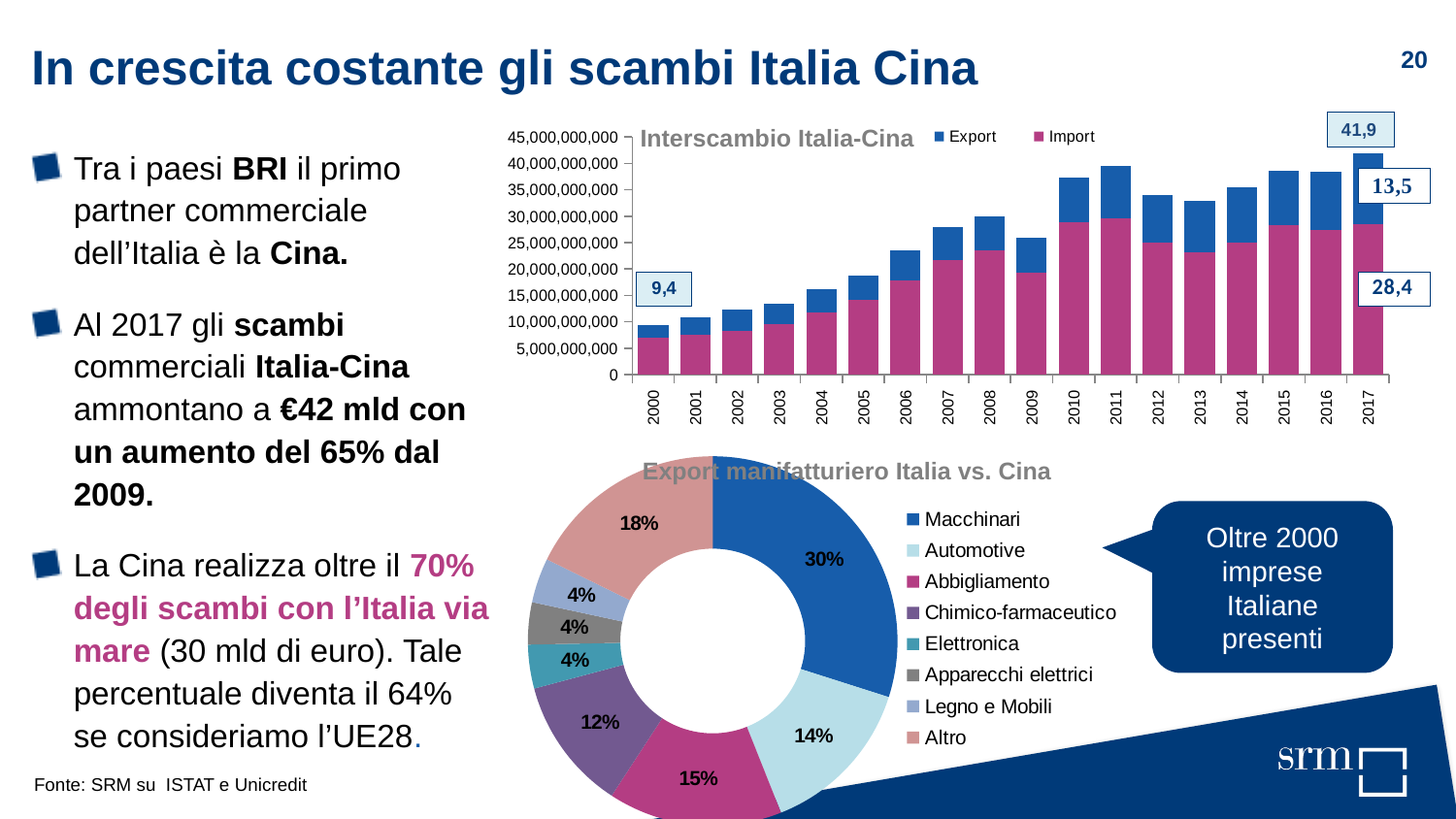
How many categories does the legend of the 'Export manifatturiero Italia vs. Cina' chart list? 8 In the 'Export manifatturiero Italia vs. Cina' chart, what is the difference in percentage points between Macchinari and Automotive? 16 In the 'Interscambio Italia-Cina' chart, do the total bar values generally rise or fall from 2000 to 2017? Rise In the 'Export manifatturiero Italia vs. Cina' chart, what share does Macchinari have? 30% In the 'Interscambio Italia-Cina' chart, what is the labelled Import value for 2017? 28,4 In the 'Interscambio Italia-Cina' chart, what is the labelled value for 2000? 9,4 What kind of chart is the 'Interscambio Italia-Cina' chart? Bar chart How many years are shown on the x axis of the 'Interscambio Italia-Cina' chart? 18 In the 'Interscambio Italia-Cina' chart, what is the labelled total value for 2017? 41,9 How many series does the legend of the 'Interscambio Italia-Cina' chart list? 2 In the 'Interscambio Italia-Cina' chart, is the total value for 2009 greater or less than 30,000,000,000? Less In the 'Export manifatturiero Italia vs. Cina' chart, which category has the largest share? Macchinari